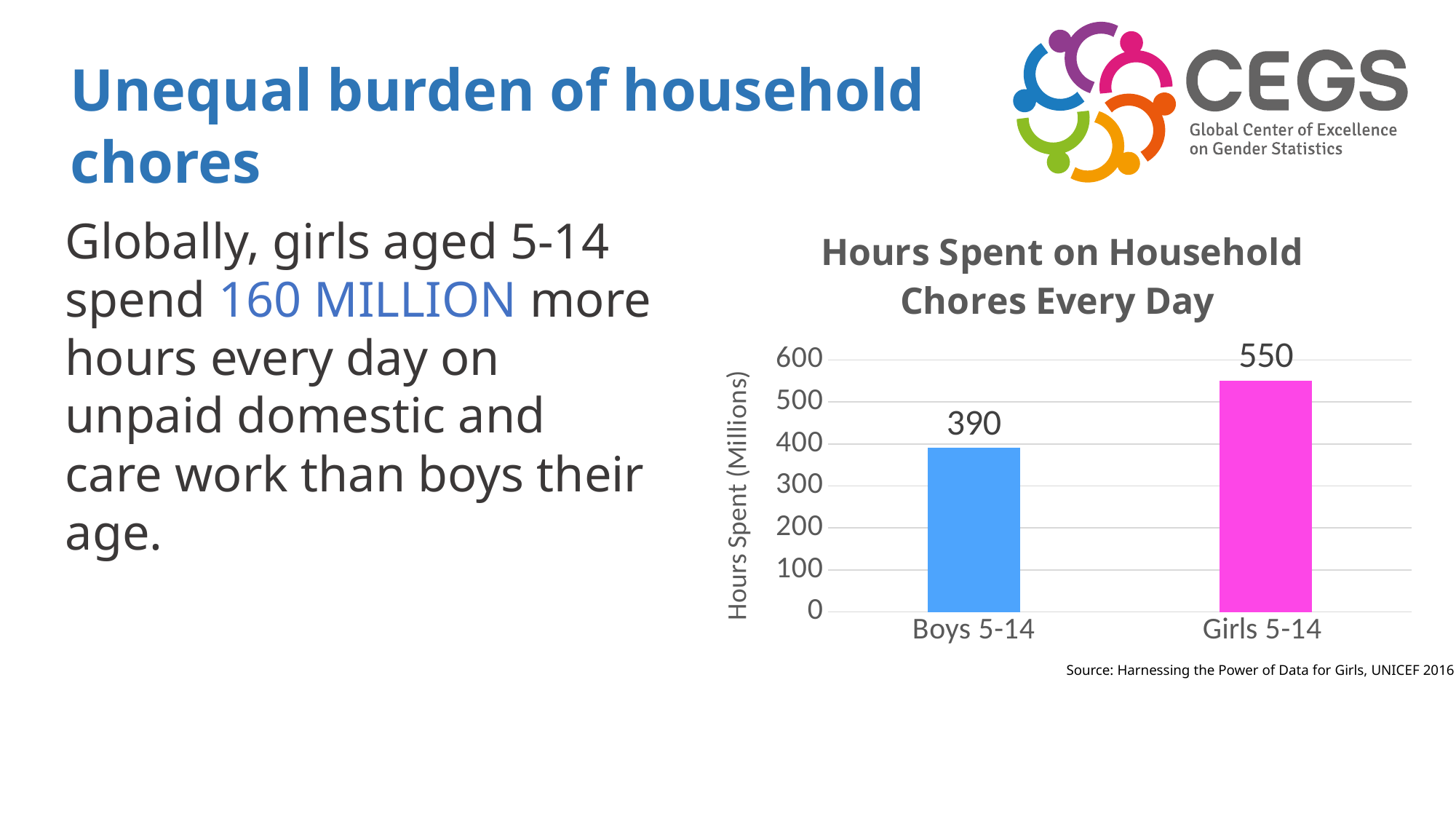
What is the title of the chart? Hours Spent on Household Chores Every Day Which category has the highest value in the chart? Girls 5-14 What is the label of the vertical axis of the chart? Hours Spent (Millions) Is the value for Girls 5-14 greater or less than 500? greater Which is larger, the value for Boys 5-14 or Girls 5-14? Girls 5-14 What kind of chart is shown on the slide? bar chart What is the value for Girls 5-14 in the chart? 550 Which category has the lowest value in the chart? Boys 5-14 What is the value for Boys 5-14 in the chart? 390 Is the value for Boys 5-14 greater or less than 400? less What is the difference between the values for Girls 5-14 and Boys 5-14? 160 How many categories are shown in the chart? 2